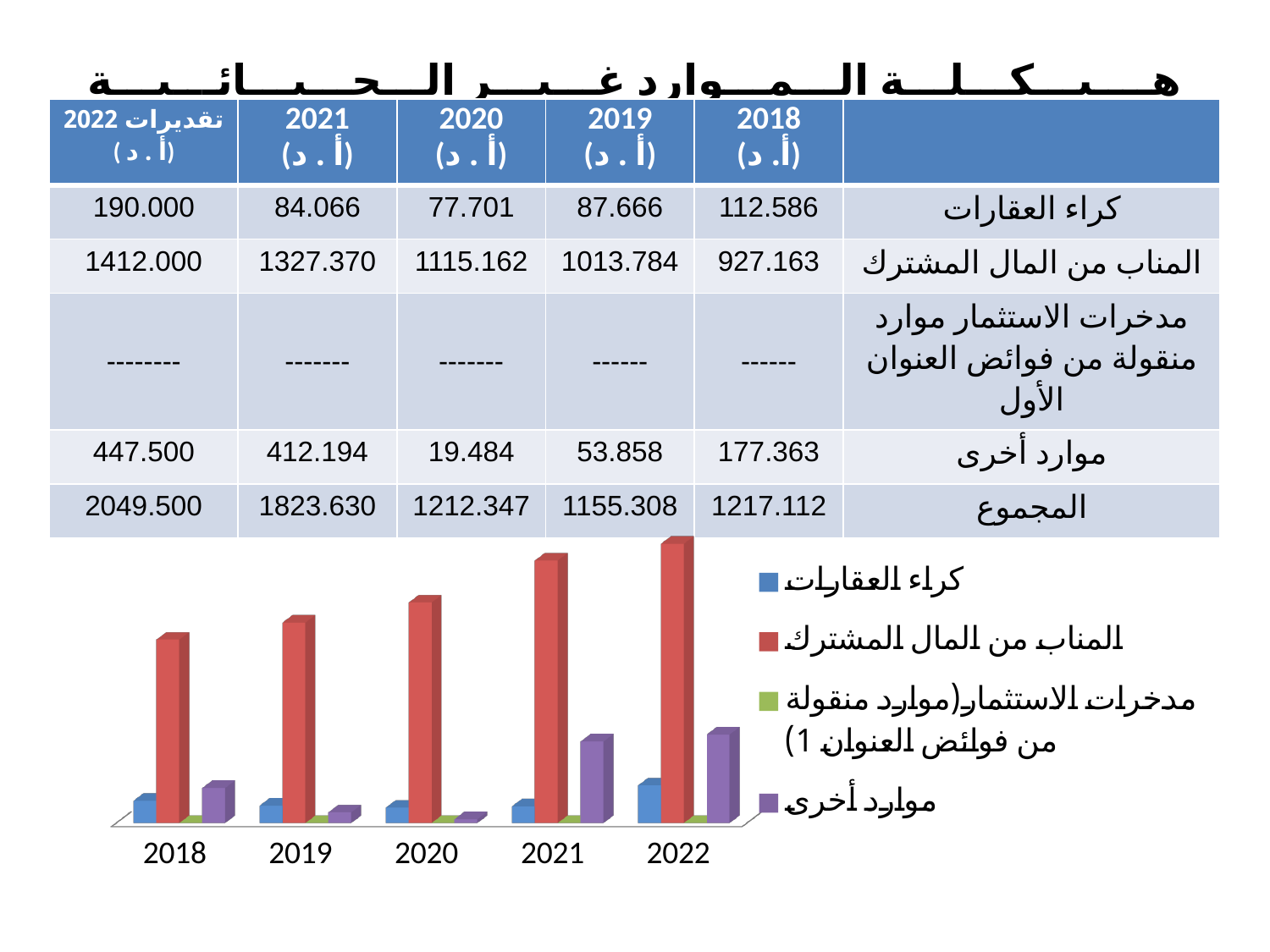
Which is larger: the bar for كراء العقارات in 2022 or in 2020? 2022 In which year is the bar for المناب من المال المشترك the tallest? 2022 What kind of chart is shown on the slide? bar chart What colour represents المناب من المال المشترك in the chart? red How many years are shown along the x axis of the chart? 5 What is the first entry listed in the chart legend? كراء العقارات Which series has the tallest bar in 2021? المناب من المال المشترك In which year is the bar for موارد أخرى the shortest? 2020 In 2018, which is larger: the bar for كراء العقارات or the bar for المناب من المال المشترك? المناب من المال المشترك How many series does the chart legend list? 4 Do the bars for المناب من المال المشترك rise or fall from 2018 to 2022? rise Which is larger: the bar for موارد أخرى in 2021 or in 2019? 2021